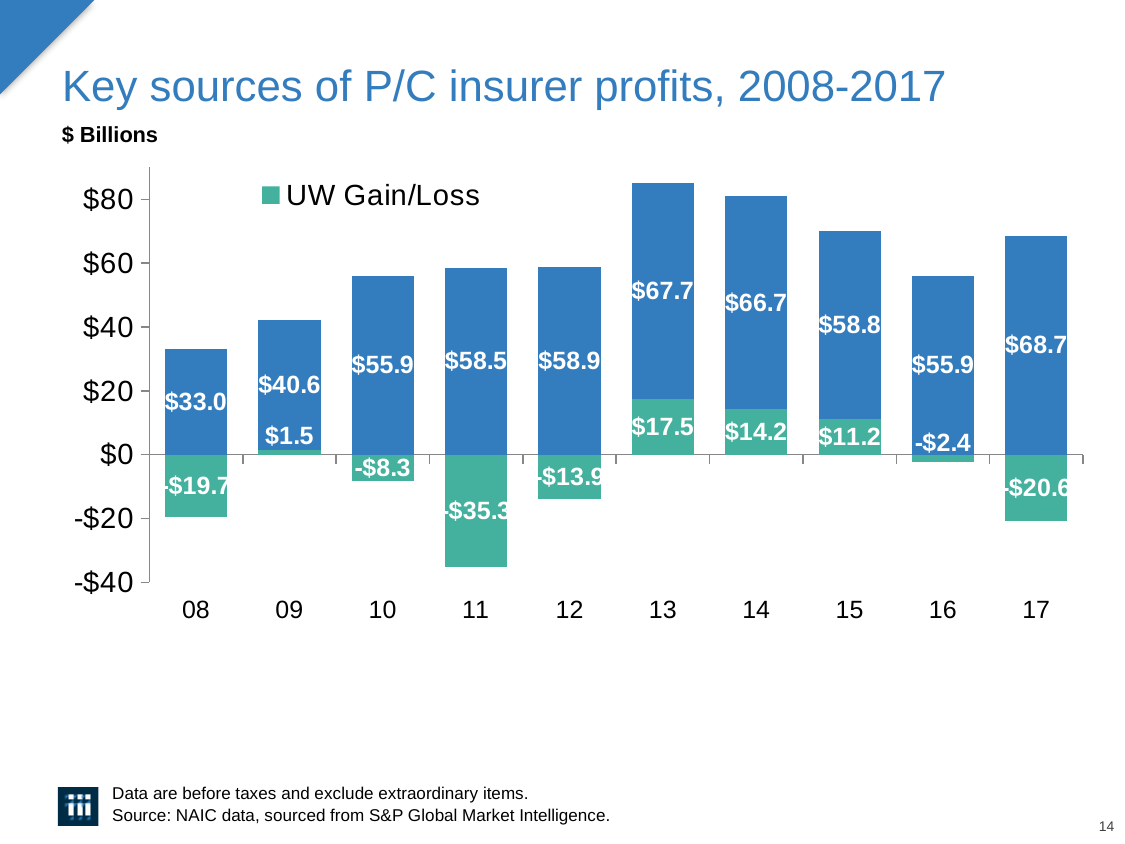
What is the value of the blue series for 17? $68.7 What is the difference between the blue series values for 17 and 08? $35.7 What is the UW Gain/Loss value for 13? $17.5 Which year has the lowest UW Gain/Loss? 11 What is the total of the stacked bar for 13? $85.2 Does the blue series rise or fall from 08 to 13? Rise What is the UW Gain/Loss value for 11? -$35.3 Which year has the highest UW Gain/Loss? 13 What kind of chart is shown on the slide? Stacked bar chart How many years are shown on the x axis? 10 Which year has the larger UW Gain/Loss, 14 or 15? 14 How many series does the legend list? 1